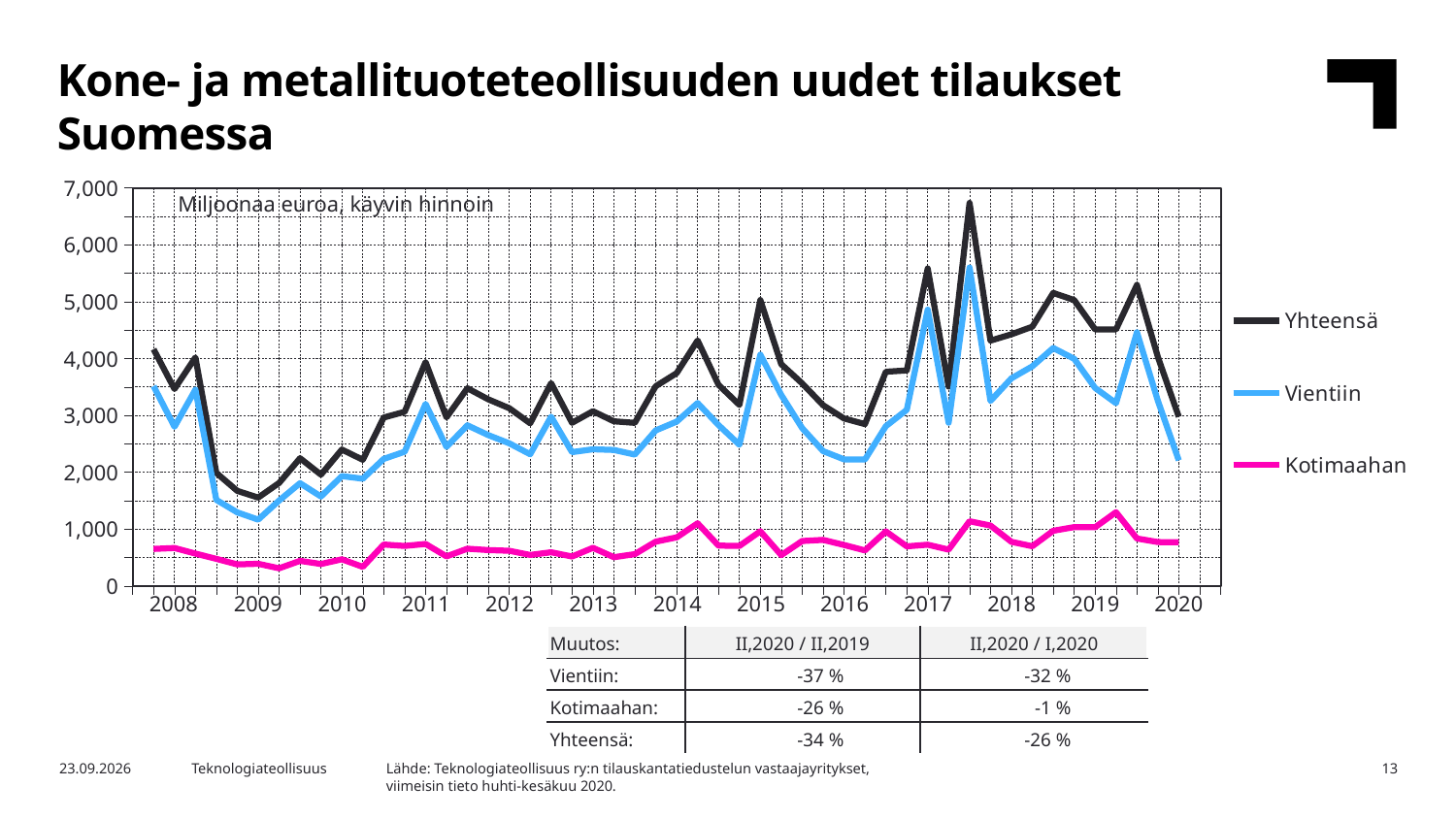
Is the Kotimaahan value at the start of 2008 greater or less than 1,000? less How many years are labelled on the x axis? 13 In which year does the Yhteensä line reach its lowest point? 2009 In which year does the Yhteensä line reach its highest peak? 2017 Is the highest value of the Yhteensä line greater or less than 6,000? greater What are the three series named in the legend? Yhteensä, Vientiin, Kotimaahan What kind of chart is shown on the slide? line chart Does the Yhteensä line rise or fall from its 2019 peak to the end of 2020? fall What unit is stated inside the chart area? Miljoonaa euroa, käyvin hinnoin Is the last Vientiin value in 2020 greater or less than 3,000? less How many series does the legend list? 3 Which series is lower throughout the whole period, Vientiin or Kotimaahan? Kotimaahan